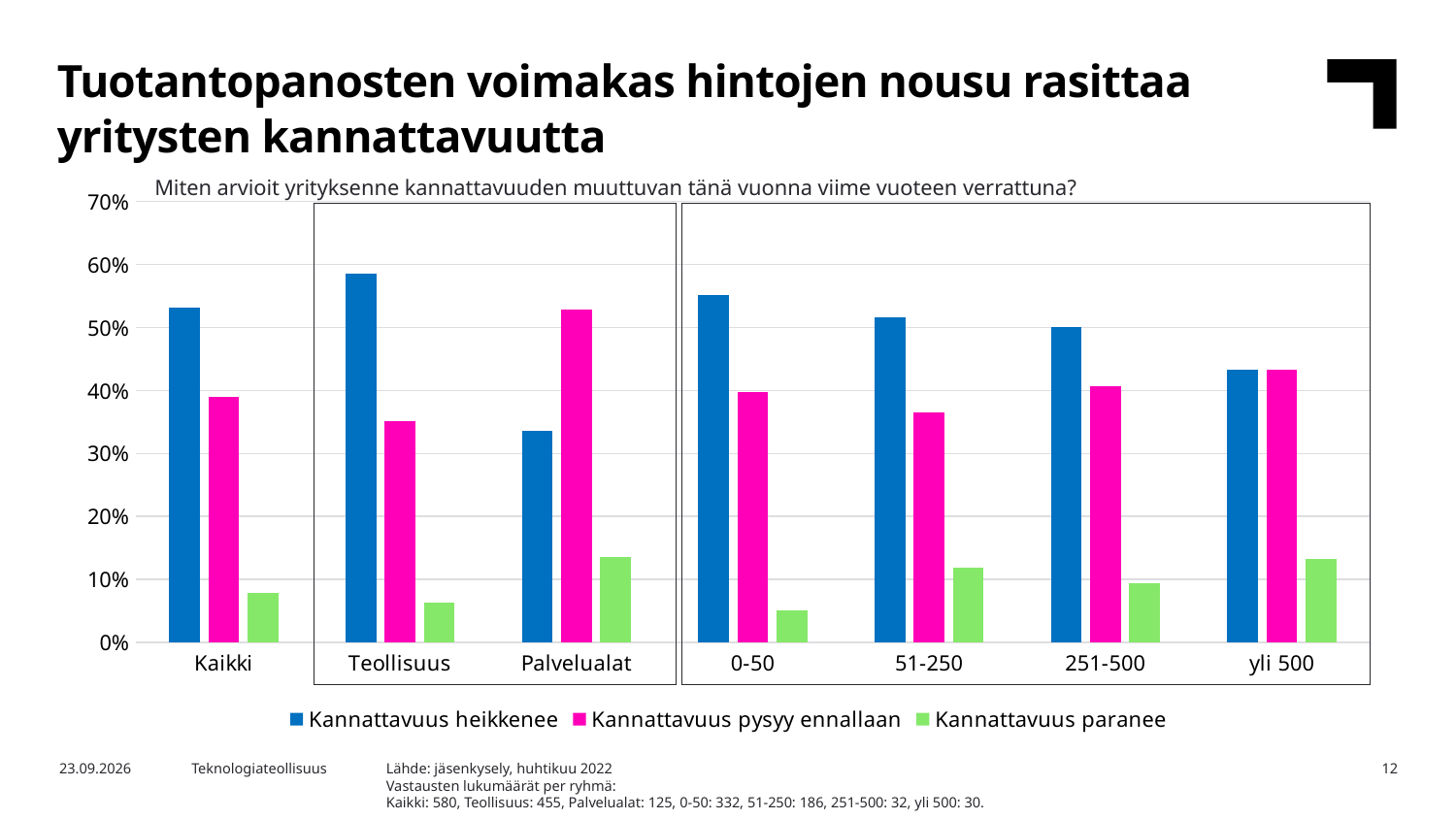
Is the value for 'Kannattavuus heikkenee' in Teollisuus greater or less than 50%? greater Which category has the lowest value for 'Kannattavuus heikkenee'? Palvelualat What kind of chart is shown on the slide? bar chart How many series does the legend list? 3 Which series is shown in green in the legend? Kannattavuus paranee Is the value for 'Kannattavuus pysyy ennallaan' in Palvelualat greater or less than 50%? greater How many categories are shown on the x axis? 7 Which category has the highest value for 'Kannattavuus heikkenee'? Teollisuus Which category has the highest value for 'Kannattavuus pysyy ennallaan'? Palvelualat In the Kaikki category, which is larger: 'Kannattavuus heikkenee' or 'Kannattavuus pysyy ennallaan'? Kannattavuus heikkenee Is the value for 'Kannattavuus paranee' in Kaikki greater or less than 10%? less